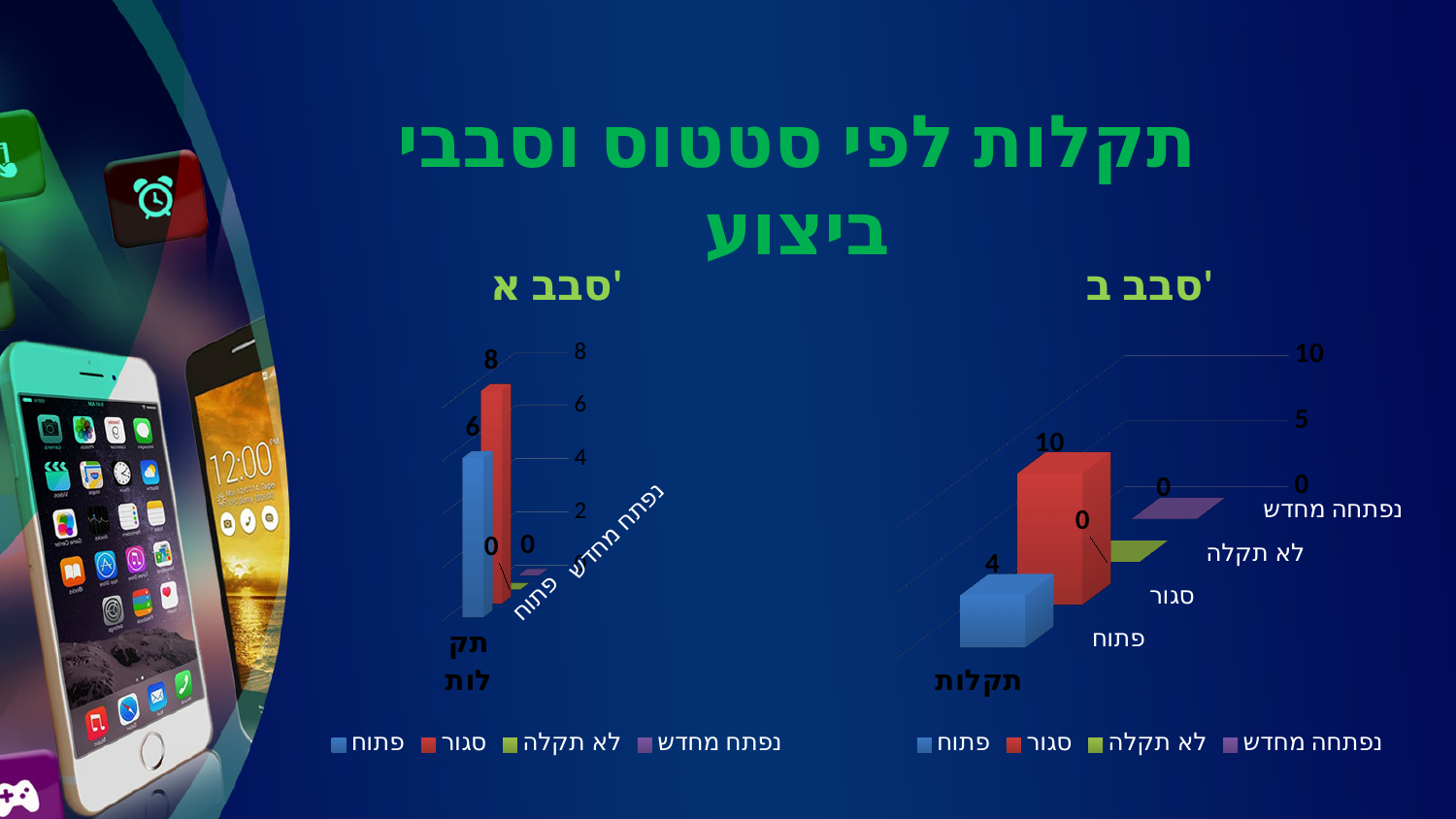
In the chart titled סבב ב', what is the value for פתוח? 4 In the chart titled סבב א', what is the difference between the values for סגור and פתוח? 2 In the chart titled סבב ב', which series has the highest value? סגור In the chart titled סבב א', what is the value for סגור? 8 In the chart titled סבב ב', what is the difference between the values for סגור and פתוח? 6 How many series does the legend of the chart titled סבב ב' list? 4 In the chart titled סבב א', what is the value for פתוח? 6 Which is larger: the value for סגור in the chart titled סבב א' or the value for סגור in the chart titled סבב ב'? סבב ב' What kind of chart is the chart titled סבב א'? bar chart In the chart titled סבב ב', what is the value for לא תקלה? 0 In the chart titled סבב ב', what is the value for סגור? 10 In the chart titled סבב א', which series has the highest value? סגור